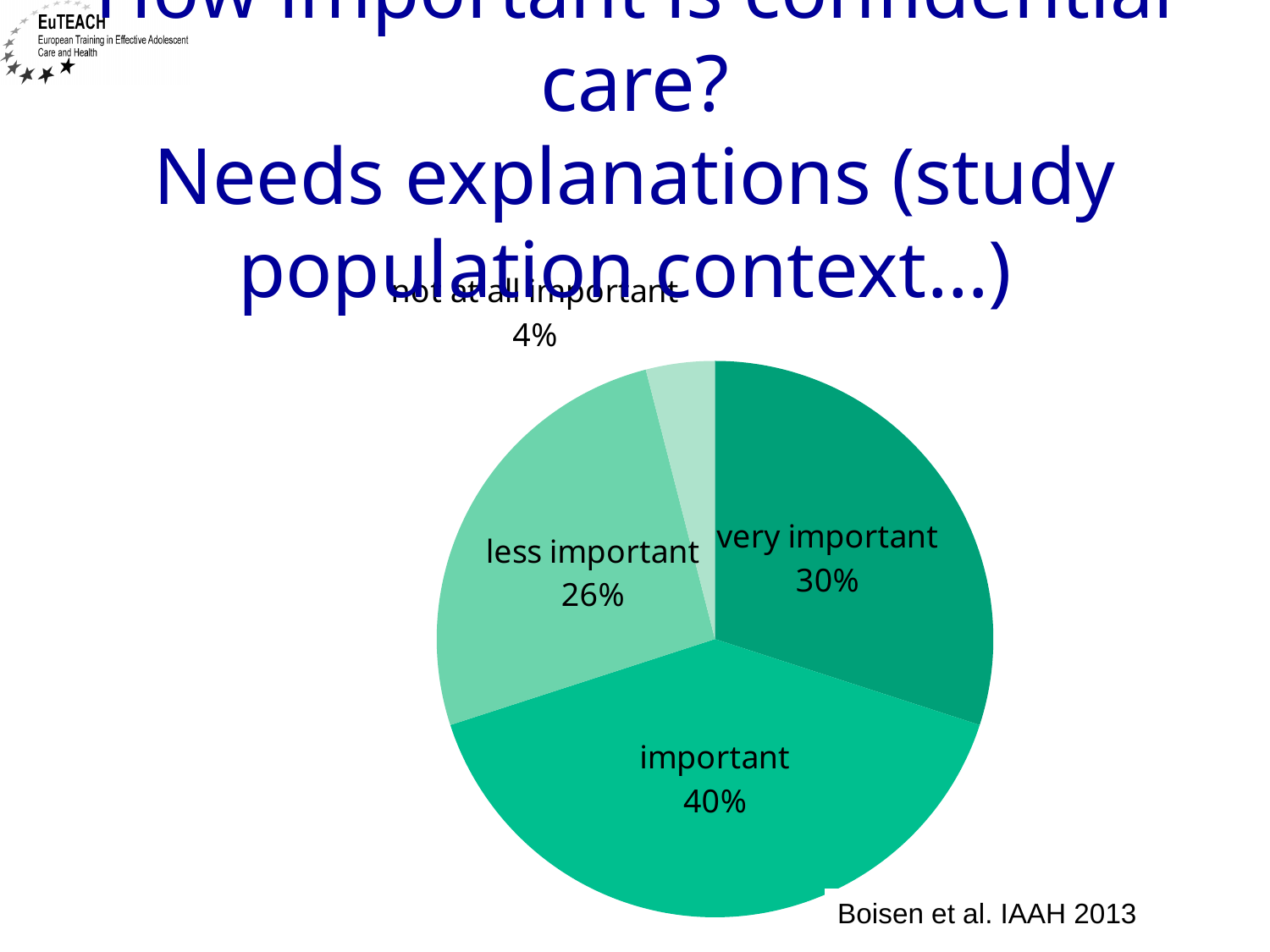
What type of chart is shown on the slide? pie chart How many slices does the pie chart have? 4 What percentage of respondents rated confidential care as 'very important'? 30% What source is cited below the chart? Boisen et al. IAAH 2013 What percentage of respondents rated confidential care as 'less important'? 26% What is the combined share of 'very important' and 'important'? 70% What percentage of respondents rated confidential care as 'important'? 40% Which is larger, the share for 'less important' or the share for 'very important'? very important Which category has the smallest share of the pie? not at all important What percentage of respondents rated confidential care as 'not at all important'? 4% Which category has the largest share of the pie? important What is the difference in percentage points between 'important' and 'very important'? 10